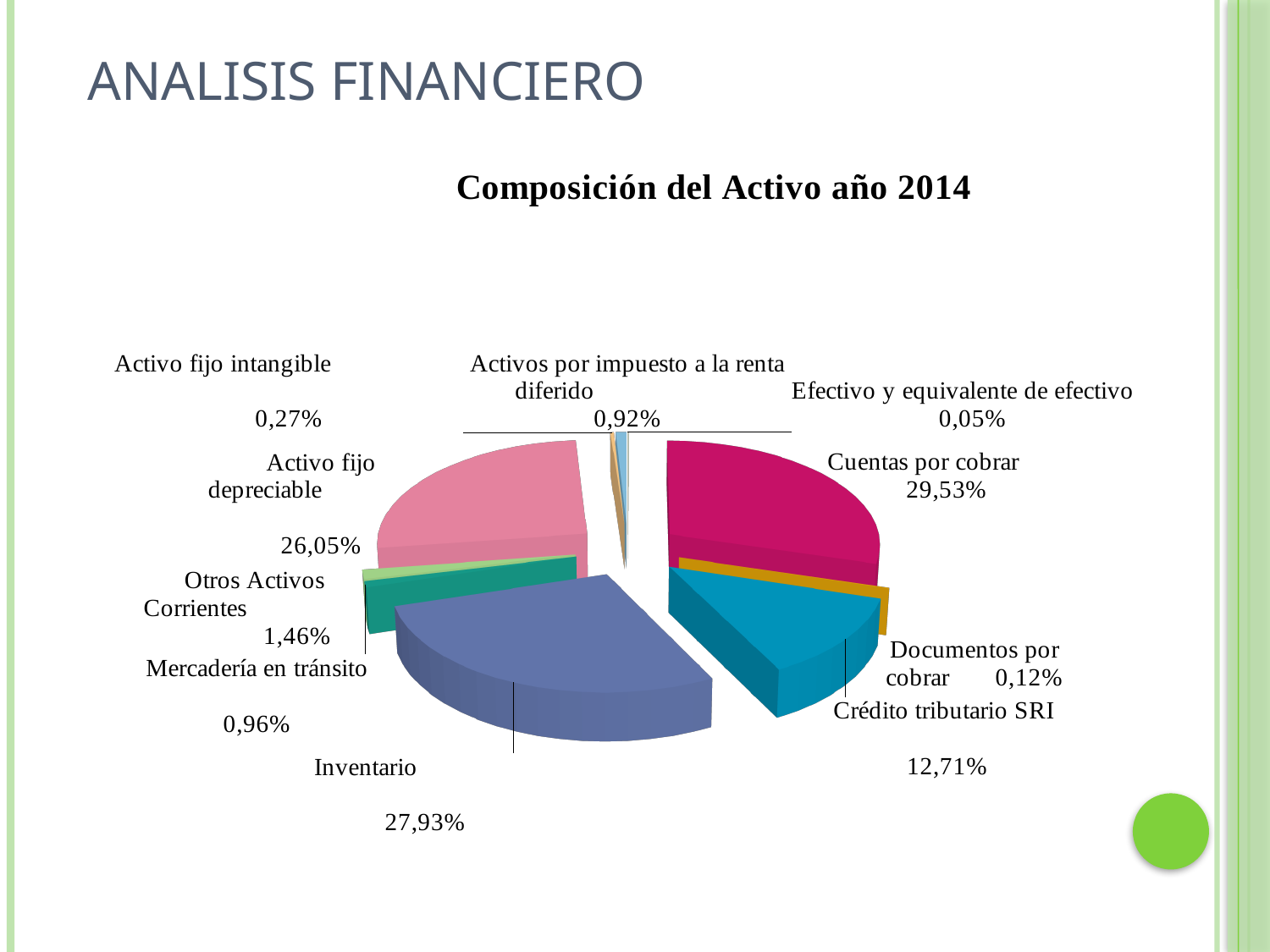
Which category has the largest share of the pie? Cuentas por cobrar What is the difference between the shares of Crédito tributario SRI and Otros Activos Corrientes? 11,25% What percentage does Cuentas por cobrar represent in the chart? 29,53% Which category has the smallest share of the pie? Efectivo y equivalente de efectivo Which is larger, the share of Inventario or the share of Activo fijo depreciable? Inventario How many categories are shown in the pie chart? 10 What percentage is shown for Activos por impuesto a la renta diferido? 0,92% What is the value shown for Crédito tributario SRI? 12,71% What is the value shown for Inventario? 27,93% What is the title of the chart? Composición del Activo año 2014 What kind of chart is shown on the slide? Pie chart What is the difference between the shares of Cuentas por cobrar and Inventario? 1,60%